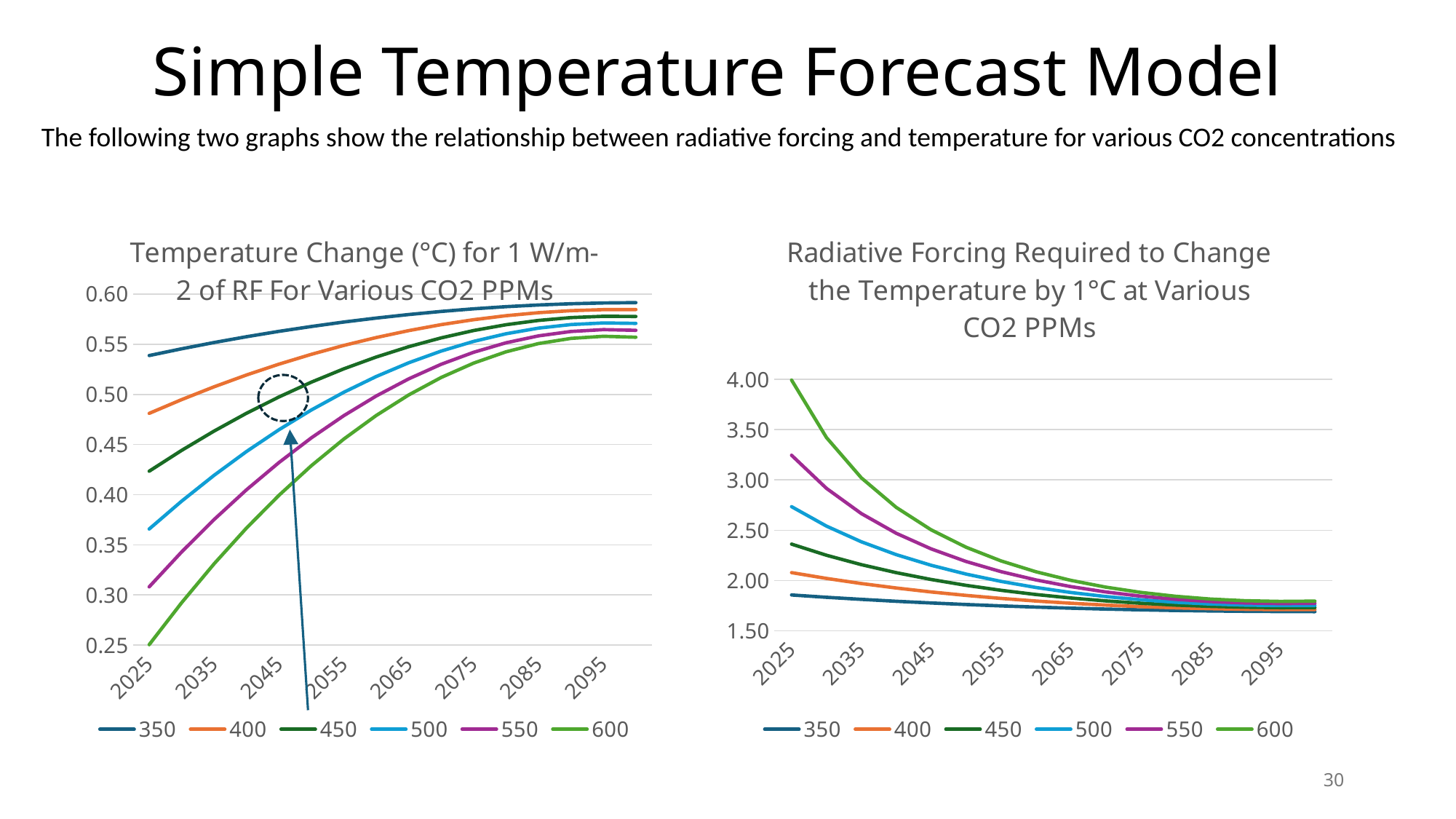
In the right chart, 'Radiative Forcing Required to Change the Temperature by 1°C', what is the value of the 600 series in 2025? 4.00 In the left chart, 'Temperature Change (°C) for 1 W/m-2 of RF', which is larger in 2025: the 400 series or the 500 series? 400 What type of chart is the left chart, 'Temperature Change (°C) for 1 W/m-2 of RF For Various CO2 PPMs'? Line chart In the left chart, 'Temperature Change (°C) for 1 W/m-2 of RF', what is the value of the 600 series in 2025? 0.25 In the left chart, 'Temperature Change (°C) for 1 W/m-2 of RF', which series has the highest value in 2025? 350 How many series does the legend of the right chart, 'Radiative Forcing Required to Change the Temperature by 1°C at Various CO2 PPMs', list? 6 In the right chart, 'Radiative Forcing Required to Change the Temperature by 1°C', which series has the lowest value in 2025? 350 In the right chart, 'Radiative Forcing Required to Change the Temperature by 1°C', do the values for the 600 series rise or fall from 2025 to 2095? Fall What are the legend entries of the left chart, 'Temperature Change (°C) for 1 W/m-2 of RF For Various CO2 PPMs'? 350, 400, 450, 500, 550, 600 In the right chart, 'Radiative Forcing Required to Change the Temperature by 1°C', is the value for the 550 series in 2025 greater or less than 3.00? greater In the left chart, 'Temperature Change (°C) for 1 W/m-2 of RF', do the values for the 600 series rise or fall from 2025 to 2095? Rise In the left chart, 'Temperature Change (°C) for 1 W/m-2 of RF', is the value for the 350 series in 2025 greater or less than 0.50? greater